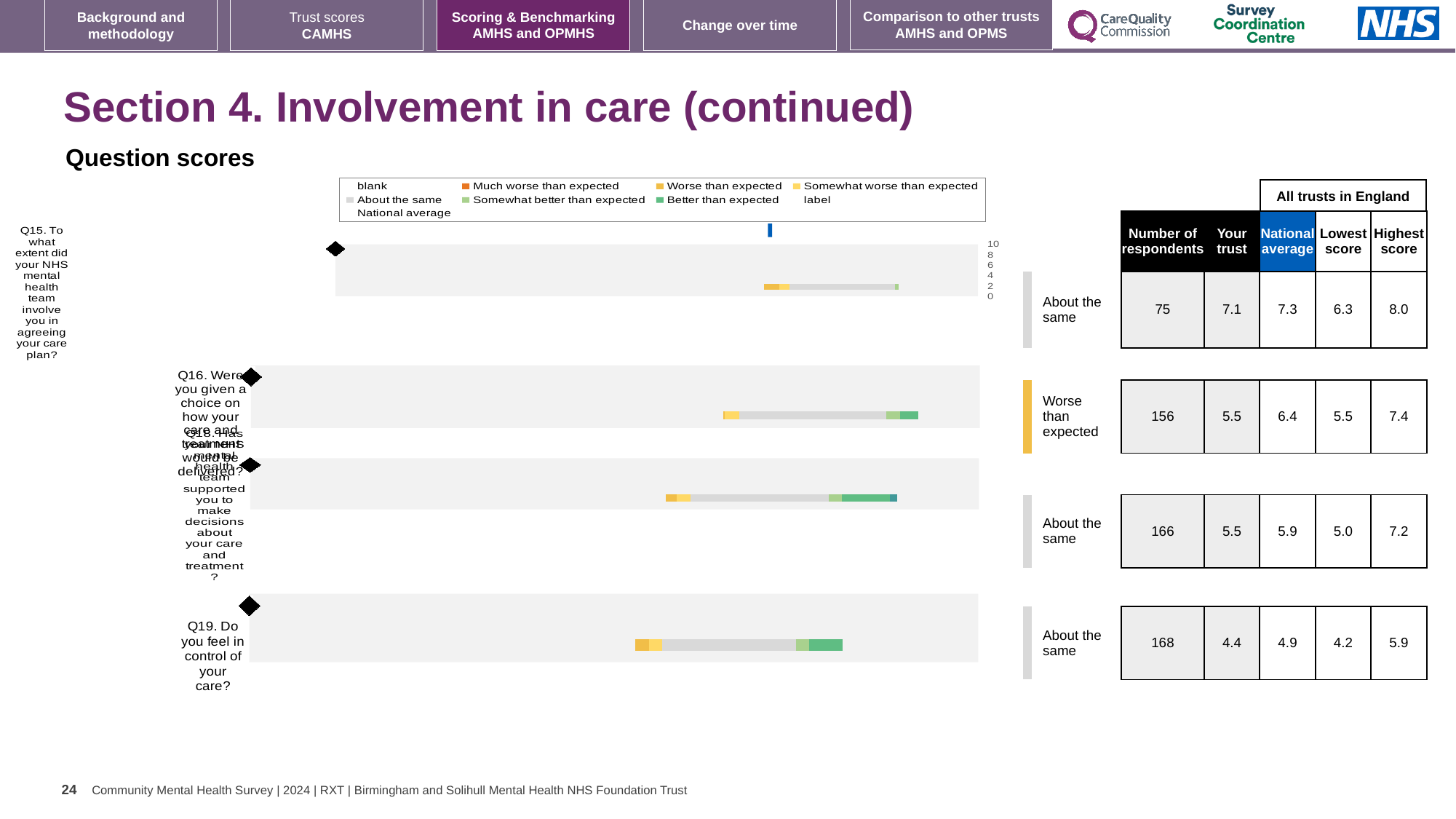
For Q16, which is larger: the 'Your trust' score or the national average? National average What is the highest score among all trusts in England for Q18? 7.2 How many questions (bars) are plotted in the question scores chart? 4 Which question has the highest 'Your trust' score? Q15 What kind of chart is used to show the question scores on this slide? bar chart In the legend, what colour represents 'Much worse than expected'? Orange Which question is rated 'Worse than expected' rather than 'About the same'? Q16 Which question has the lowest 'Your trust' score? Q19 What is the national average score for Q19 (Do you feel in control of your care?)? 4.9 How many respondents answered Q16 (choice on how care and treatment would be delivered)? 156 What is the 'Your trust' score for Q15 (involving you in agreeing your care plan)? 7.1 What is the difference between the highest score (8.0) and the lowest score (6.3) for Q15? 1.7